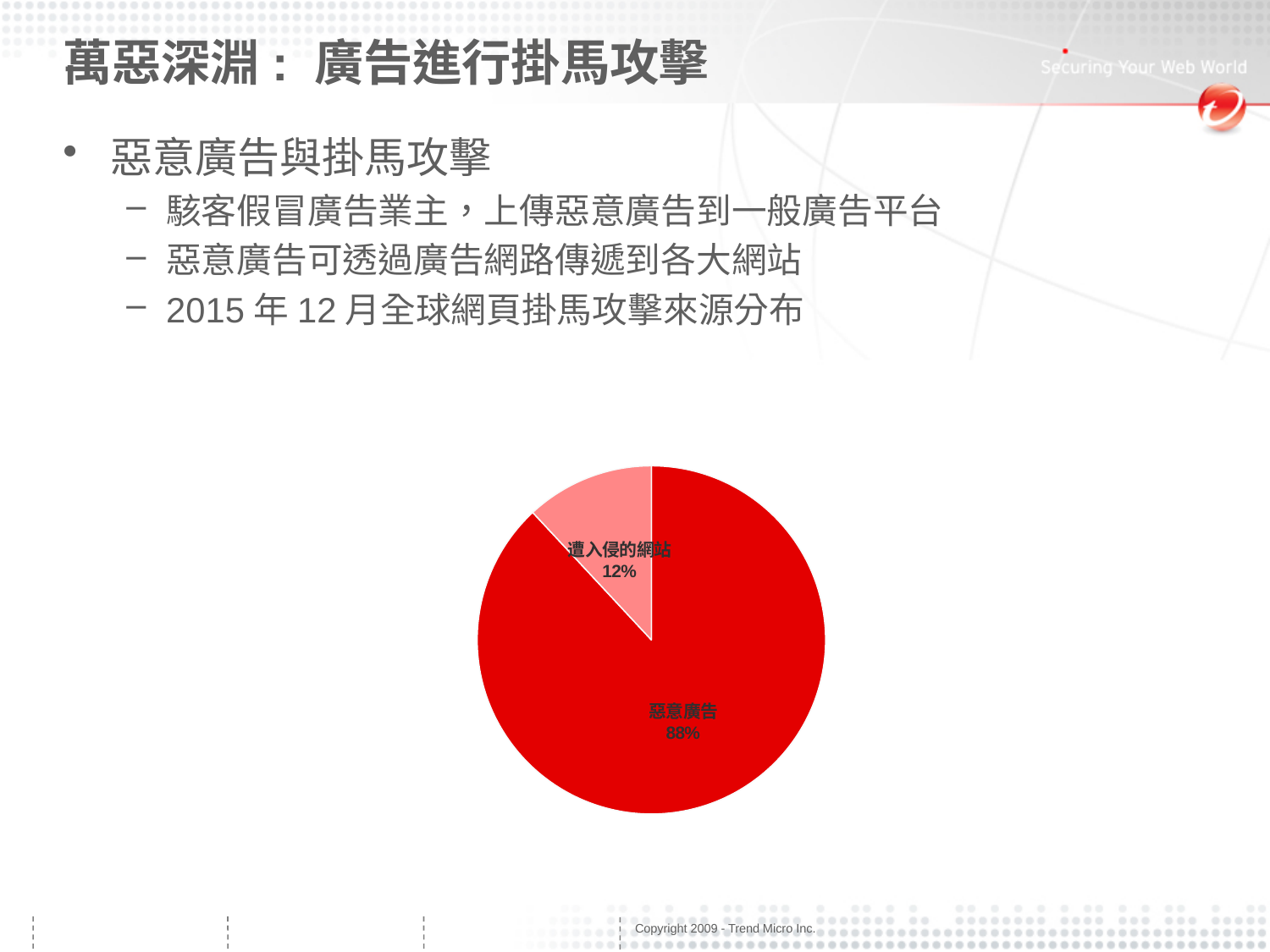
What is the difference in percentage points between the 惡意廣告 slice and the 遭入侵的網站 slice? 76 What share of the pie does 遭入侵的網站 account for? 12% What kind of chart is shown on the slide? pie chart Which is larger, the 惡意廣告 slice or the 遭入侵的網站 slice? 惡意廣告 Is the share for 惡意廣告 greater or less than 50%? greater What colour is the 遭入侵的網站 slice of the pie? pink Is the share for 遭入侵的網站 greater or less than 25%? less How many slices does the pie chart have? 2 Which slice of the pie is the smallest? 遭入侵的網站 What colour is the 惡意廣告 slice of the pie? red Which slice of the pie is the largest? 惡意廣告 What share of the pie does 惡意廣告 account for? 88%